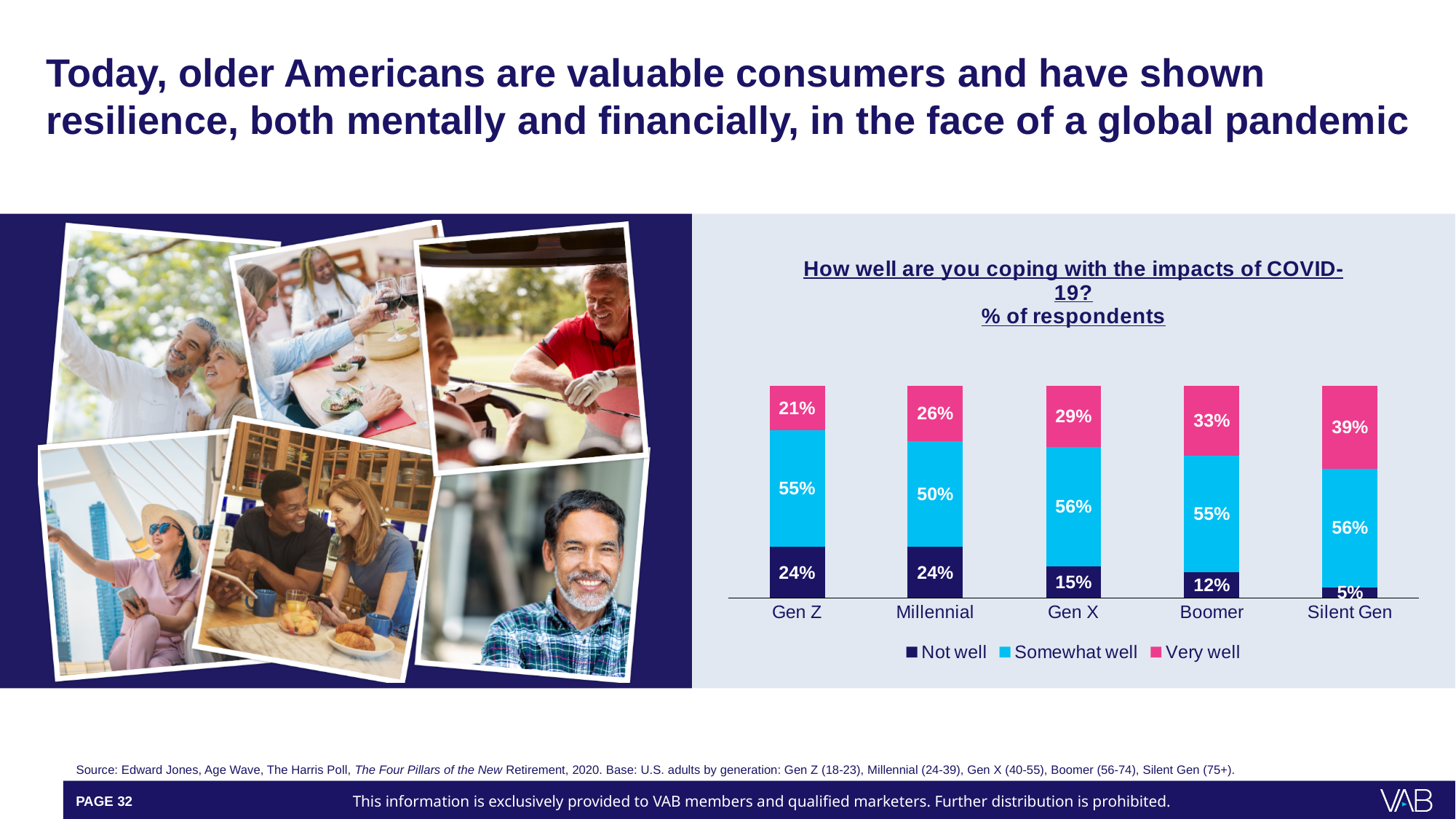
What percentage of Millennial respondents said they are coping "Somewhat well"? 50% What is the total of the three segments in the Boomer bar? 100% How many generations are shown on the x axis? 5 Do the "Very well" percentages rise or fall moving from Gen Z to Silent Gen? Rise What kind of chart is shown on the slide? Stacked bar chart What percentage of Gen Z respondents said they are coping "Not well"? 24% Which generation has the lowest "Not well" percentage? Silent Gen Which is larger: the "Not well" percentage for Gen X or for Boomer? Gen X How many series does the legend list? 3 Which generation has the highest "Very well" percentage? Silent Gen What is the difference between the "Very well" percentages for Boomer and Gen Z? 12% What percentage of Silent Gen respondents said they are coping "Very well"? 39%